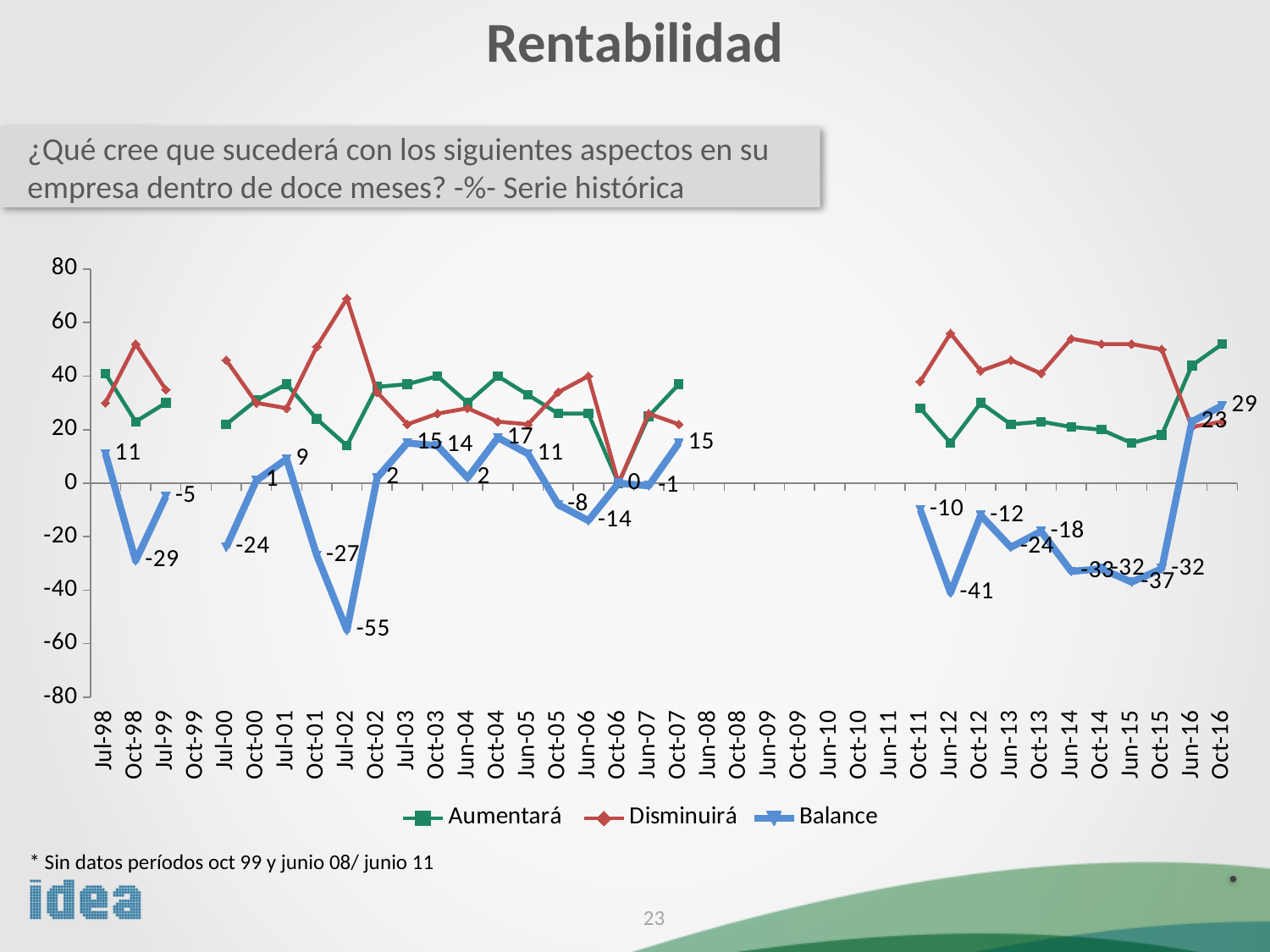
How many series does the legend list? 3 At which period does the Balance series reach its lowest value? Jul-02 What is the difference between the Balance values for Oct-16 and Jun-16? 6 Is the Disminuirá value for Jul-02 greater or less than 60? greater What kind of chart is shown on the slide? Line chart At which period does the Balance series reach its highest value? Oct-16 What is the Balance value for Jul-02? -55 Which is larger, the Balance value for Jul-98 or for Oct-07? Oct-07 Does the Balance series rise or fall from Jun-15 to Oct-16? Rise What is the Balance value for Oct-16? 29 What is the Balance value for Jun-12? -41 Is the Aumentará value for Oct-16 greater or less than 40? greater